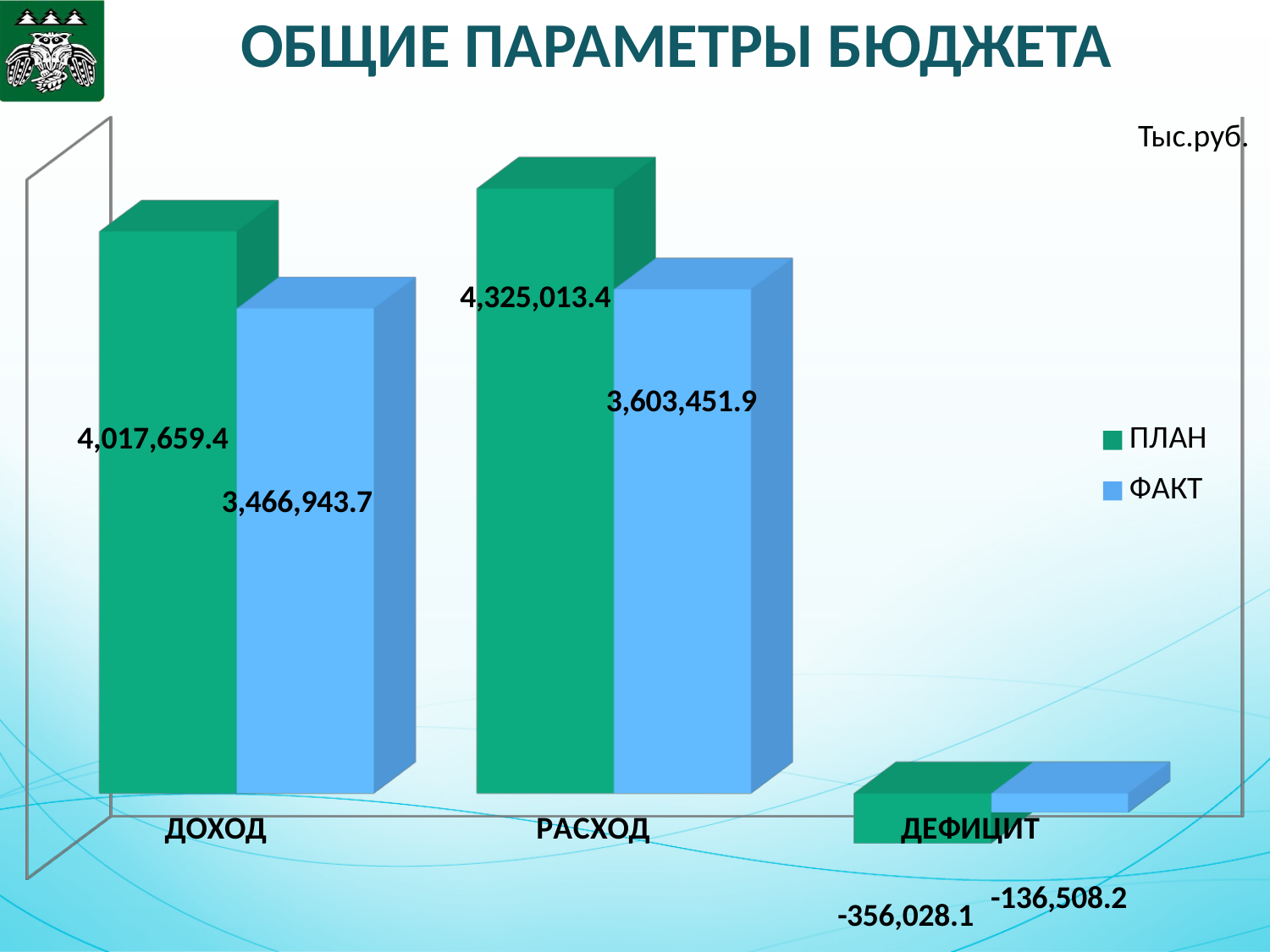
How many categories are shown on the x axis? 3 How many series does the legend list? 2 Which category has the lowest ФАКТ value? ДЕФИЦИТ What is the difference between the ПЛАН and ФАКТ values for ДОХОД? 550,715.7 What is the difference between the ПЛАН and ФАКТ values for РАСХОД? 721,561.5 What is the ФАКТ value for ДЕФИЦИТ? -136,508.2 What kind of chart is shown on the slide? Bar chart Which is larger for ДОХОД, the ПЛАН value or the ФАКТ value? ПЛАН What is the ПЛАН value for ДОХОД? 4,017,659.4 What is the ФАКТ value for РАСХОД? 3,603,451.9 Which category has the highest ПЛАН value? РАСХОД What is the ПЛАН value for ДЕФИЦИТ? -356,028.1